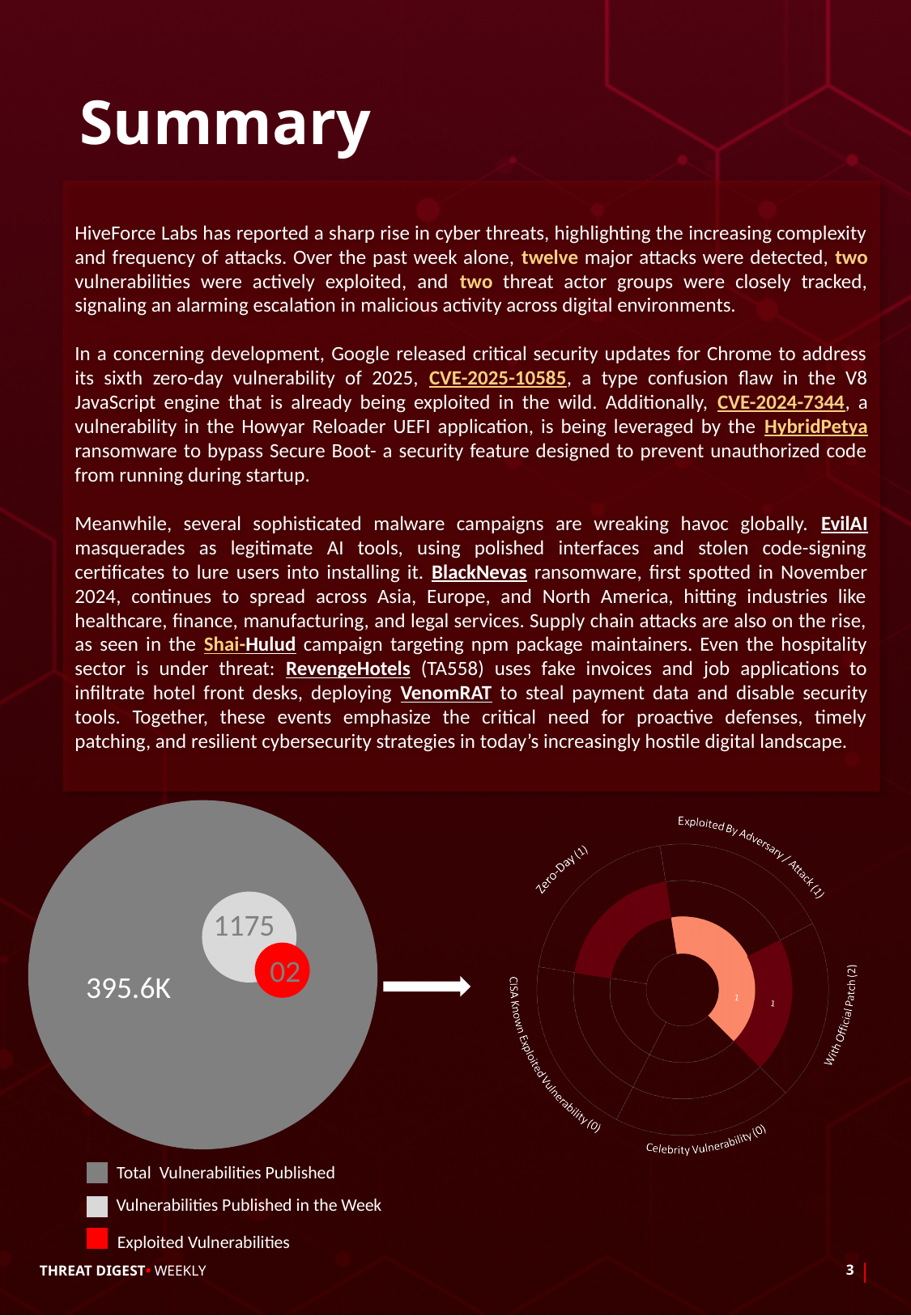
In the bubble chart on the left, what is the value shown for Vulnerabilities Published in the Week? 1175 In the bubble chart on the left, what is the value shown for Exploited Vulnerabilities? 02 In the radial chart on the right, what is the value for Zero-Day? 1 In the bubble chart on the left, what is the value shown for Total Vulnerabilities Published? 395.6K In the radial chart on the right, what is the value for Celebrity Vulnerability? 0 In the bubble chart on the left, how many entries does the legend list? 3 In the bubble chart on the left, which legend entry is shown in red? Exploited Vulnerabilities In the radial chart on the right, what is the value for With Official Patch? 2 In the bubble chart on the left, which category has the largest value? Total Vulnerabilities Published In the radial chart on the right, what is the value for CISA Known Exploited Vulnerability? 0 In the radial chart on the right, which category has the highest value? With Official Patch In the radial chart on the right, how many categories are shown? 5